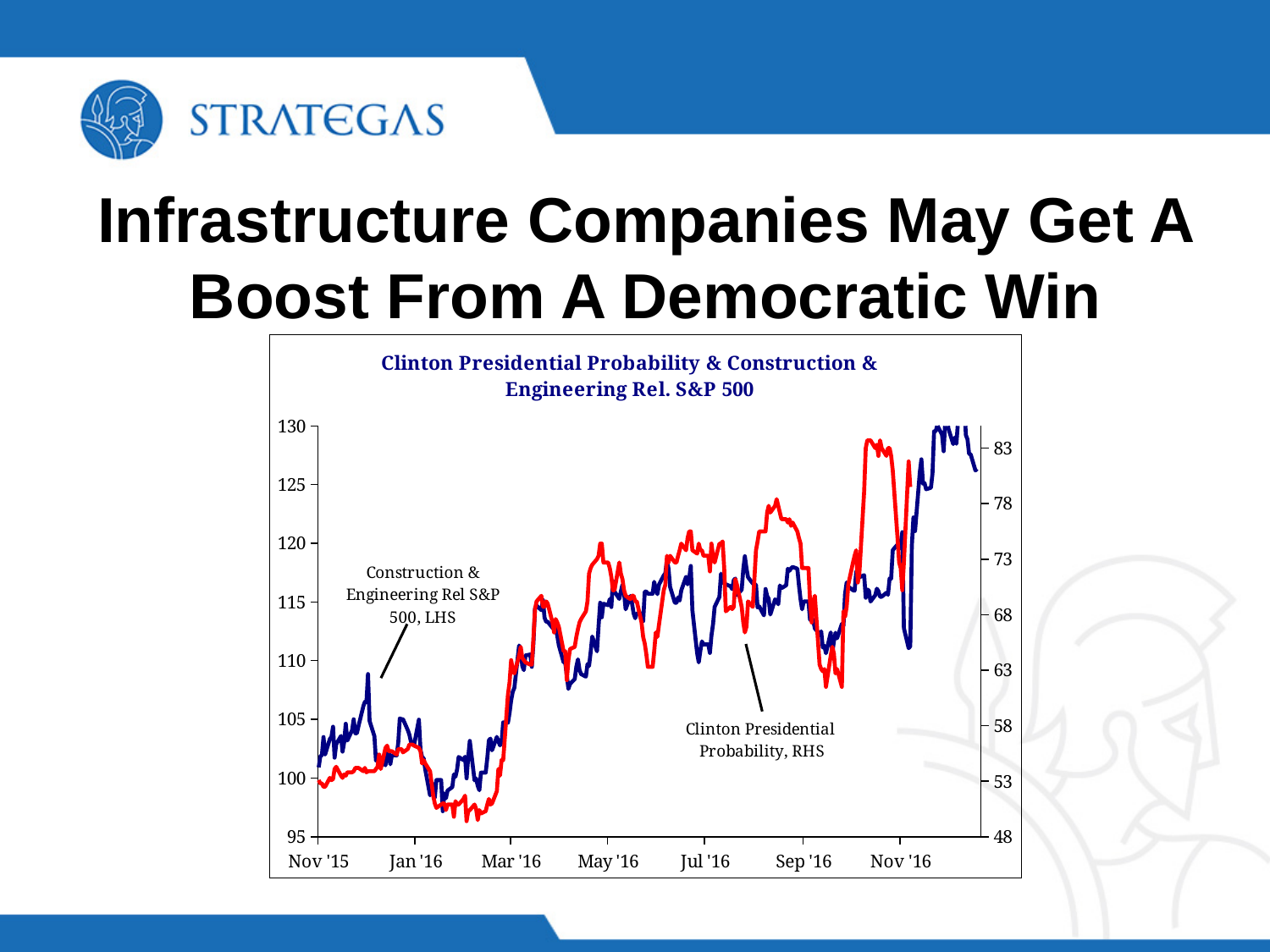
How many data series are plotted on the chart? 2 Which colour is used for the Clinton Presidential Probability line? Red What kind of chart is shown on the slide? Line chart How many date labels are shown on the x axis? 7 Is the value of Construction & Engineering Rel S&P 500 at Nov '15 greater or less than 105? less Does the Construction & Engineering Rel S&P 500 line overall rise or fall from Nov '15 to Nov '16? Rise Is the Clinton Presidential Probability at Nov '15 greater or less than 58? less Does the Clinton Presidential Probability line overall rise or fall from Nov '15 to Nov '16? Rise Is the Clinton Presidential Probability at its peak in Oct '16 greater or less than 78? greater What is the title of the chart? Clinton Presidential Probability & Construction & Engineering Rel. S&P 500